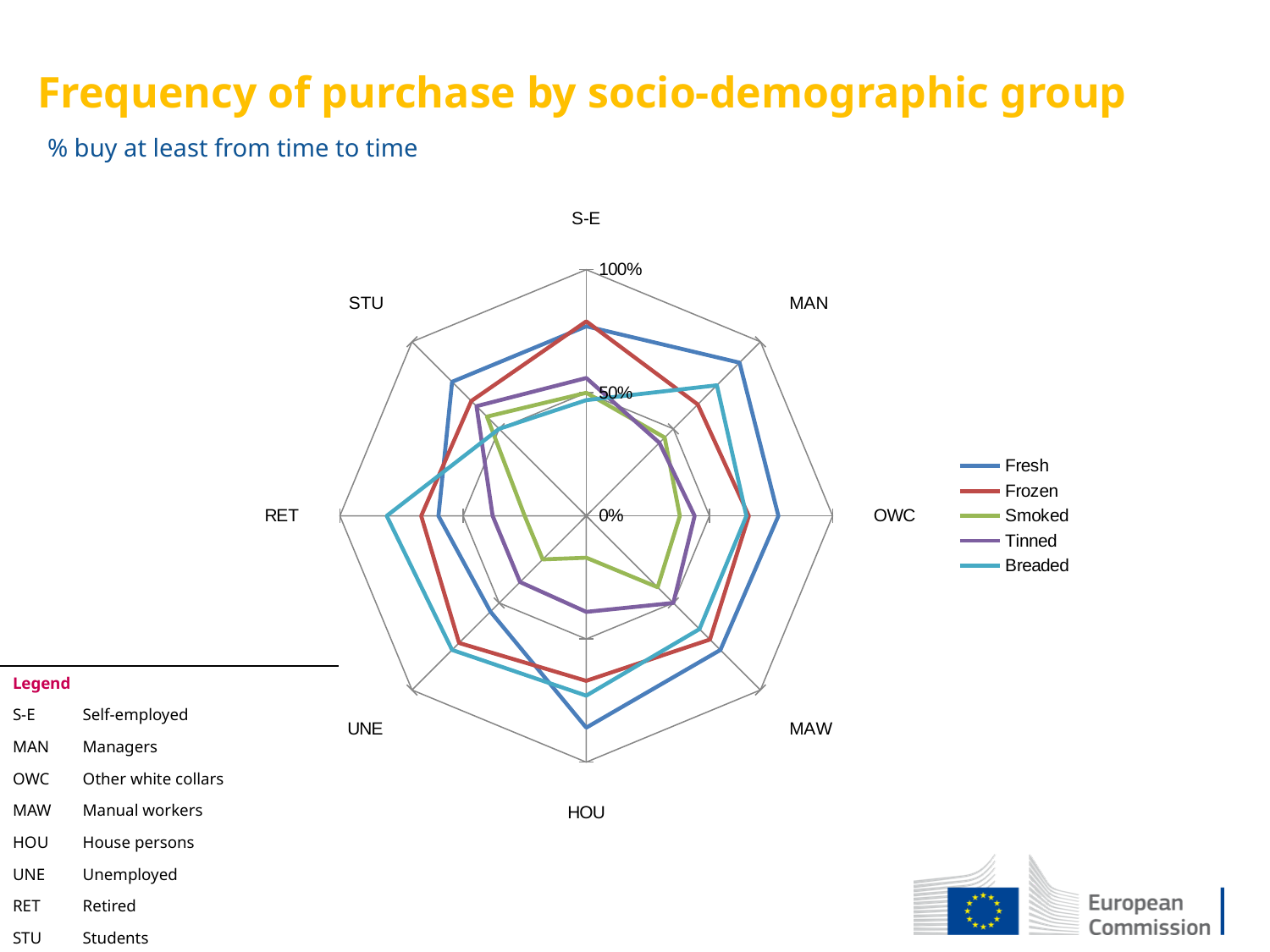
Is the Fresh value for HOU greater or less than 50%? greater How many socio-demographic groups (axes) does the radar chart have? 8 For RET, which is larger: the Breaded value or the Frozen value? Breaded How many series does the chart legend list? 5 Which series has the highest value for HOU? Fresh What kind of chart is shown on the slide? Radar chart Is the Fresh value for S-E greater or less than 50%? greater Is the Tinned value for UNE greater or less than 50%? less What is the title of the slide's chart? Frequency of purchase by socio-demographic group According to the legend on the slide, what does the abbreviation OWC stand for? Other white collars Which series has the lowest value for HOU? Smoked